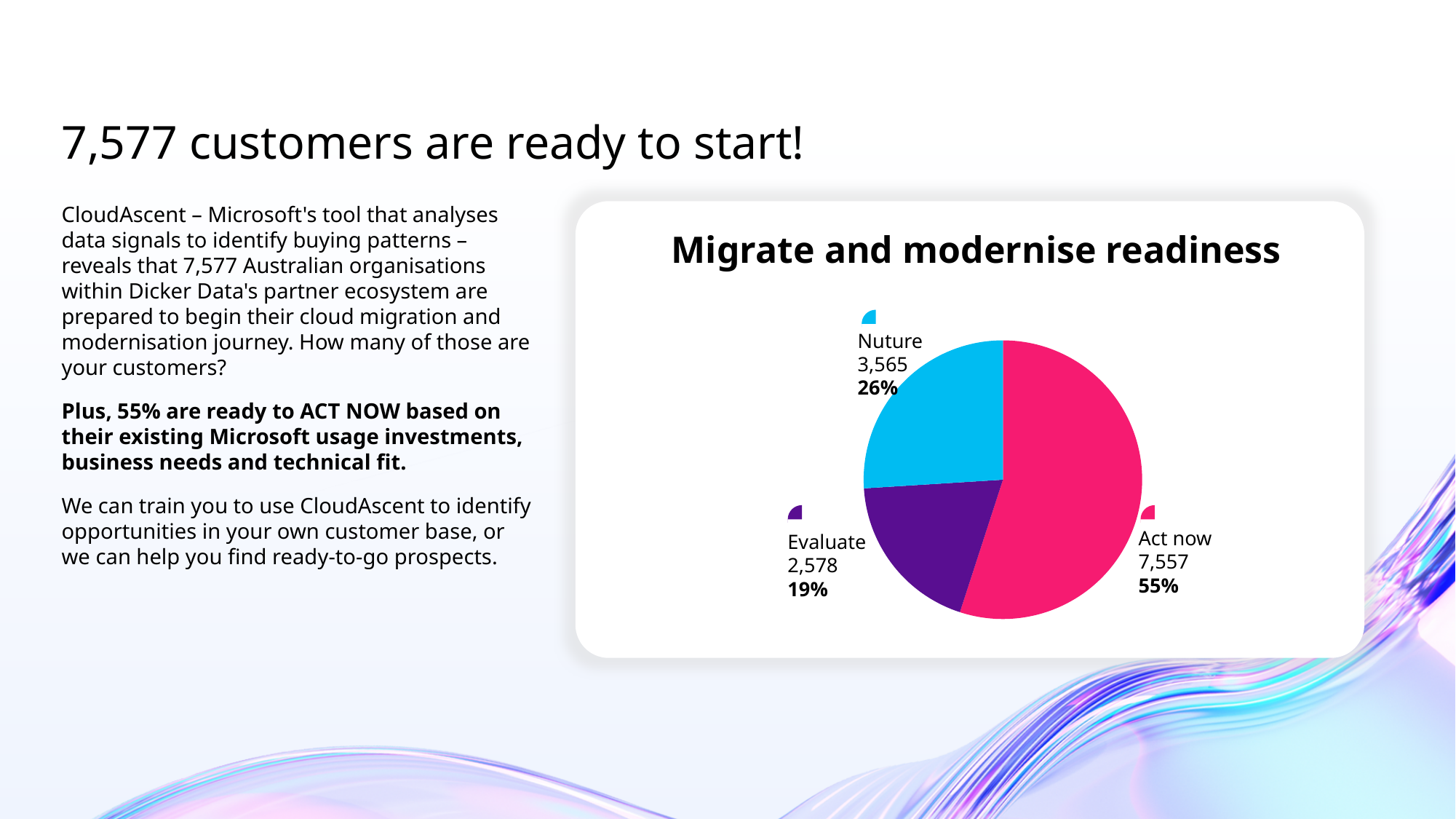
How many slices does the pie chart have? 3 What is the title of the chart? Migrate and modernise readiness What is the value shown for the Act now slice? 7,557 What kind of chart is shown on the slide? Pie chart Which is larger, the Nuture slice or the Evaluate slice? Nuture What share of the pie does the Evaluate slice represent? 19% What is the difference between the Act now value and the Nuture value? 3,992 What is the value shown for the Evaluate slice? 2,578 Which slice is the smallest? Evaluate Which slice is the largest? Act now What is the value shown for the Nuture slice? 3,565 What share of the pie does the Act now slice represent? 55%